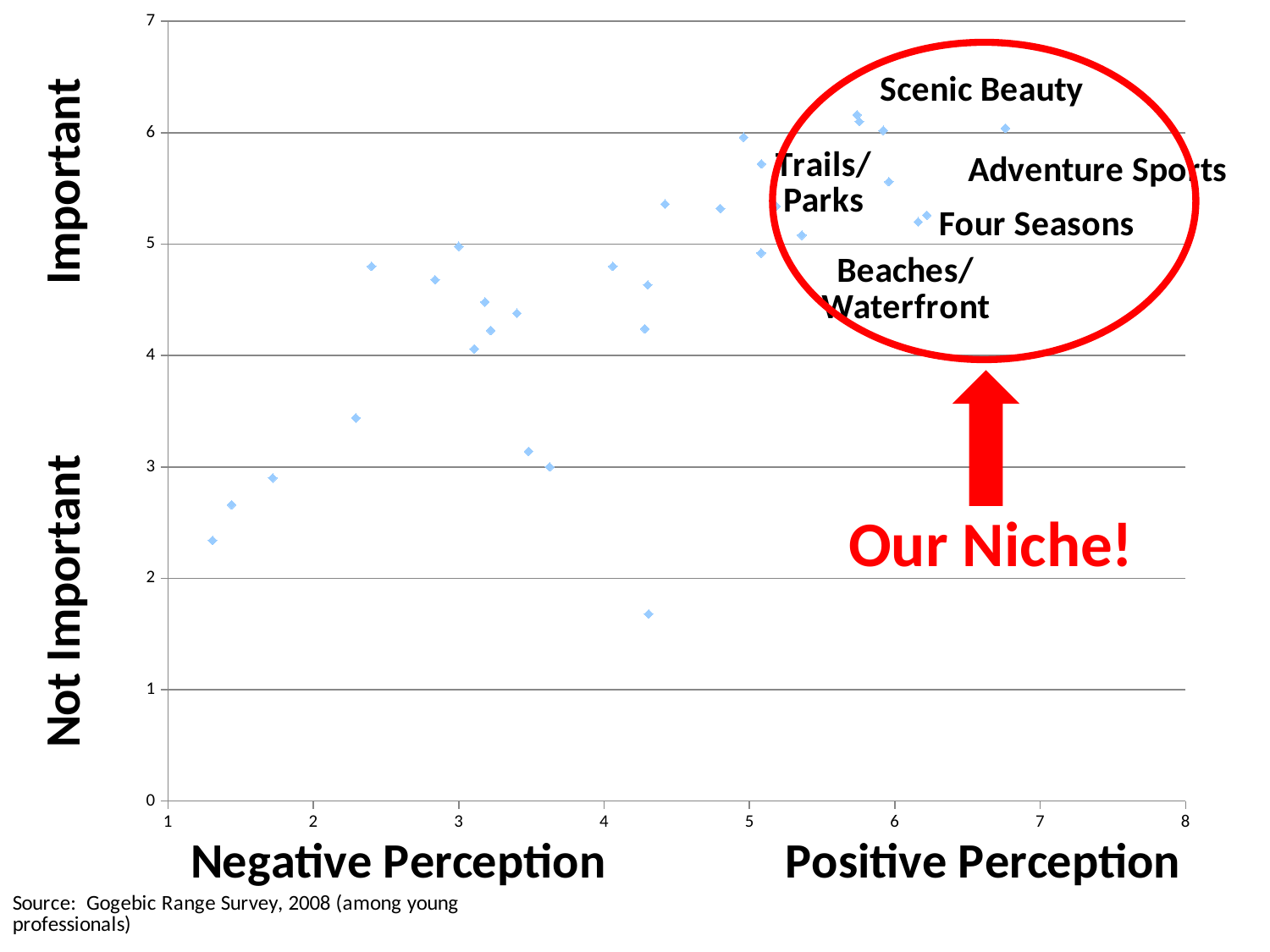
Is the importance value for Beaches/Waterfront greater or less than 4? greater Do the importance values generally rise or fall as perception moves from negative to positive along the x axis? rise Is the importance value of the lowest point on the chart greater or less than 2? less What is the highest value shown on the y axis? 7 Is the perception value for Four Seasons greater or less than 5? greater How many attractions are named inside the red circle labelled "Our Niche!"? 5 What kind of chart is shown on the slide? scatter chart What text is written in red below the circled group of points? Our Niche!